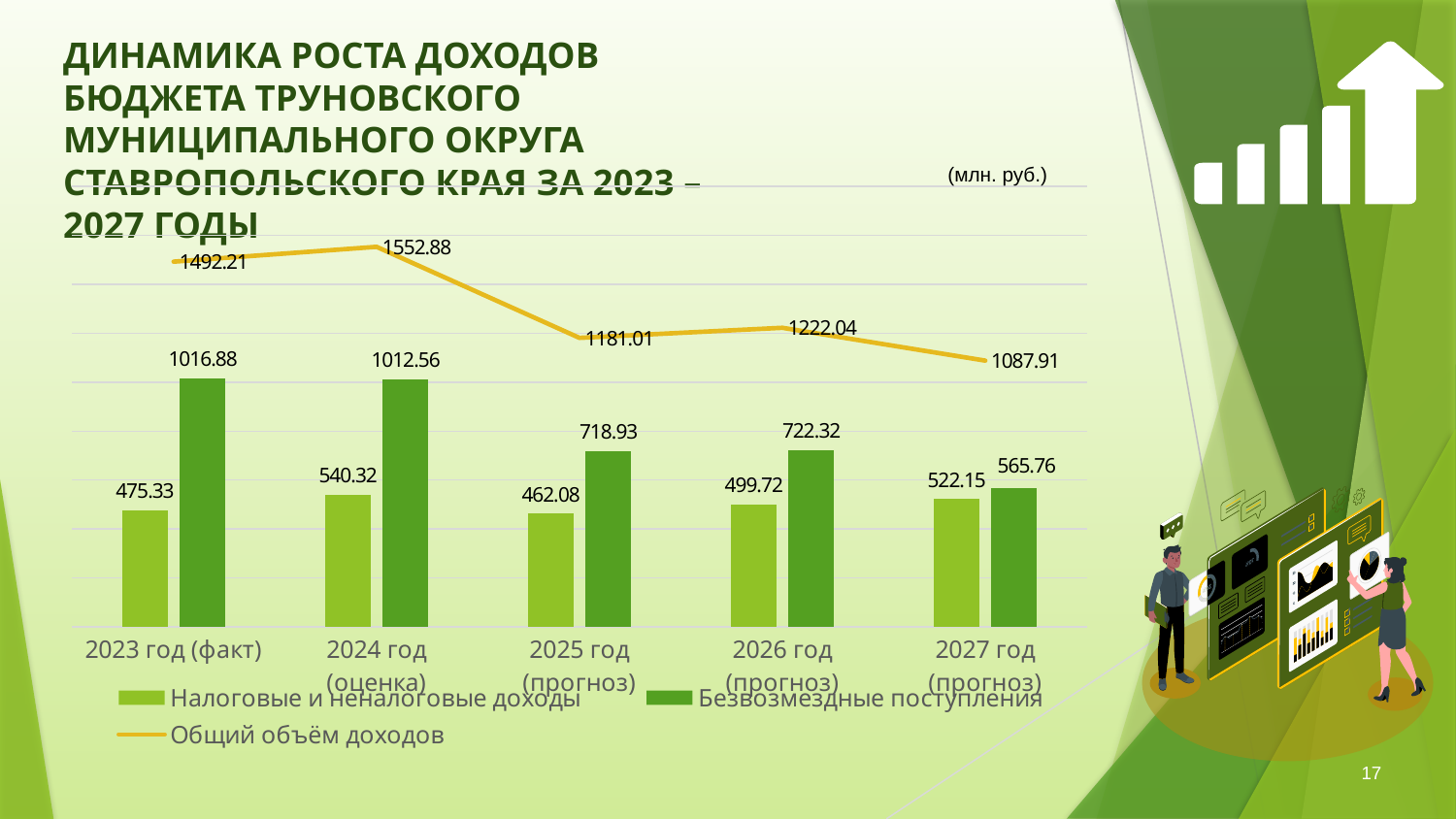
What unit is indicated for the values on the chart? млн. руб. What is the value of Налоговые и неналоговые доходы for 2023 год (факт)? 475.33 Which is larger in 2027 год (прогноз): Налоговые и неналоговые доходы or Безвозмездные поступления? Безвозмездные поступления How many years (categories) are shown on the x axis? 5 Does Общий объём доходов rise or fall from 2024 год (оценка) to 2027 год (прогноз)? Fall In which year is Общий объём доходов highest? 2024 год (оценка) What is the value of Безвозмездные поступления for 2025 год (прогноз)? 718.93 What kind of chart is shown on the slide? Combined bar and line chart What is the value of Общий объём доходов for 2024 год (оценка)? 1552.88 What is the difference between Безвозмездные поступления and Налоговые и неналоговые доходы in 2026 год (прогноз)? 222.60 In which year is Безвозмездные поступления lowest? 2027 год (прогноз) How many series does the legend list? 3